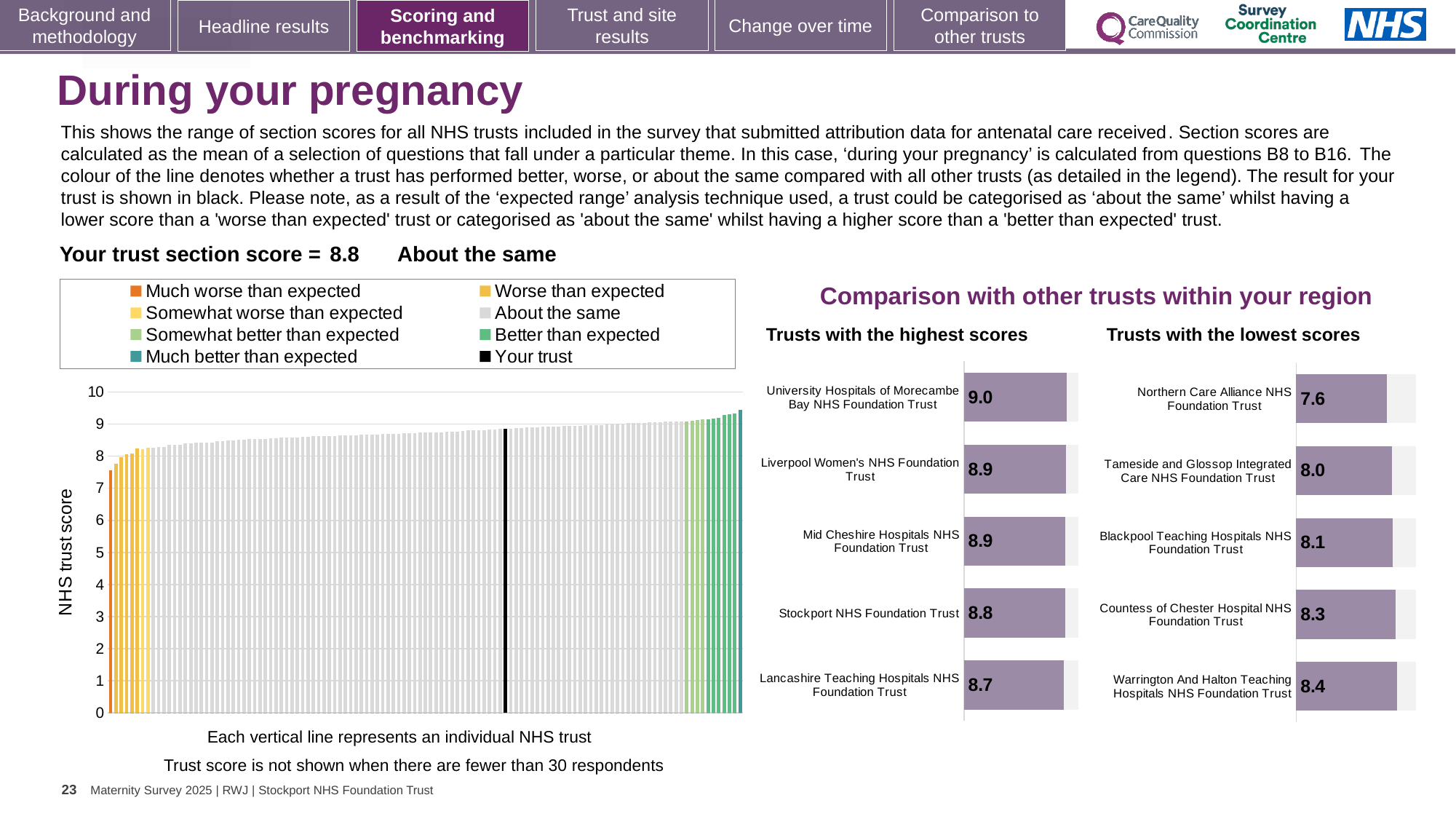
In the 'Trusts with the highest scores' chart, which has the larger score: Lancashire Teaching Hospitals NHS Foundation Trust or Liverpool Women's NHS Foundation Trust? Liverpool Women's NHS Foundation Trust In the large chart on the left, do the trust scores rise or fall from left to right? Rise In the 'Trusts with the highest scores' chart, which trust has the highest score? University Hospitals of Morecambe Bay NHS Foundation Trust How many entries does the legend above the large chart on the left list? 8 In the 'Trusts with the highest scores' chart, what is the score for University Hospitals of Morecambe Bay NHS Foundation Trust? 9.0 In the 'Trusts with the highest scores' chart, what is the score for Stockport NHS Foundation Trust? 8.8 In the 'Trusts with the lowest scores' chart, what is the score for Blackpool Teaching Hospitals NHS Foundation Trust? 8.1 In the 'Trusts with the lowest scores' chart, how many trusts are shown? 5 In the 'Trusts with the lowest scores' chart, what is the difference between the scores of Warrington And Halton Teaching Hospitals NHS Foundation Trust and Northern Care Alliance NHS Foundation Trust? 0.8 What kind of chart is the large chart on the left showing NHS trust scores? Bar chart In the 'Trusts with the lowest scores' chart, what is the score for Northern Care Alliance NHS Foundation Trust? 7.6 In the 'Trusts with the lowest scores' chart, which trust has the lowest score? Northern Care Alliance NHS Foundation Trust